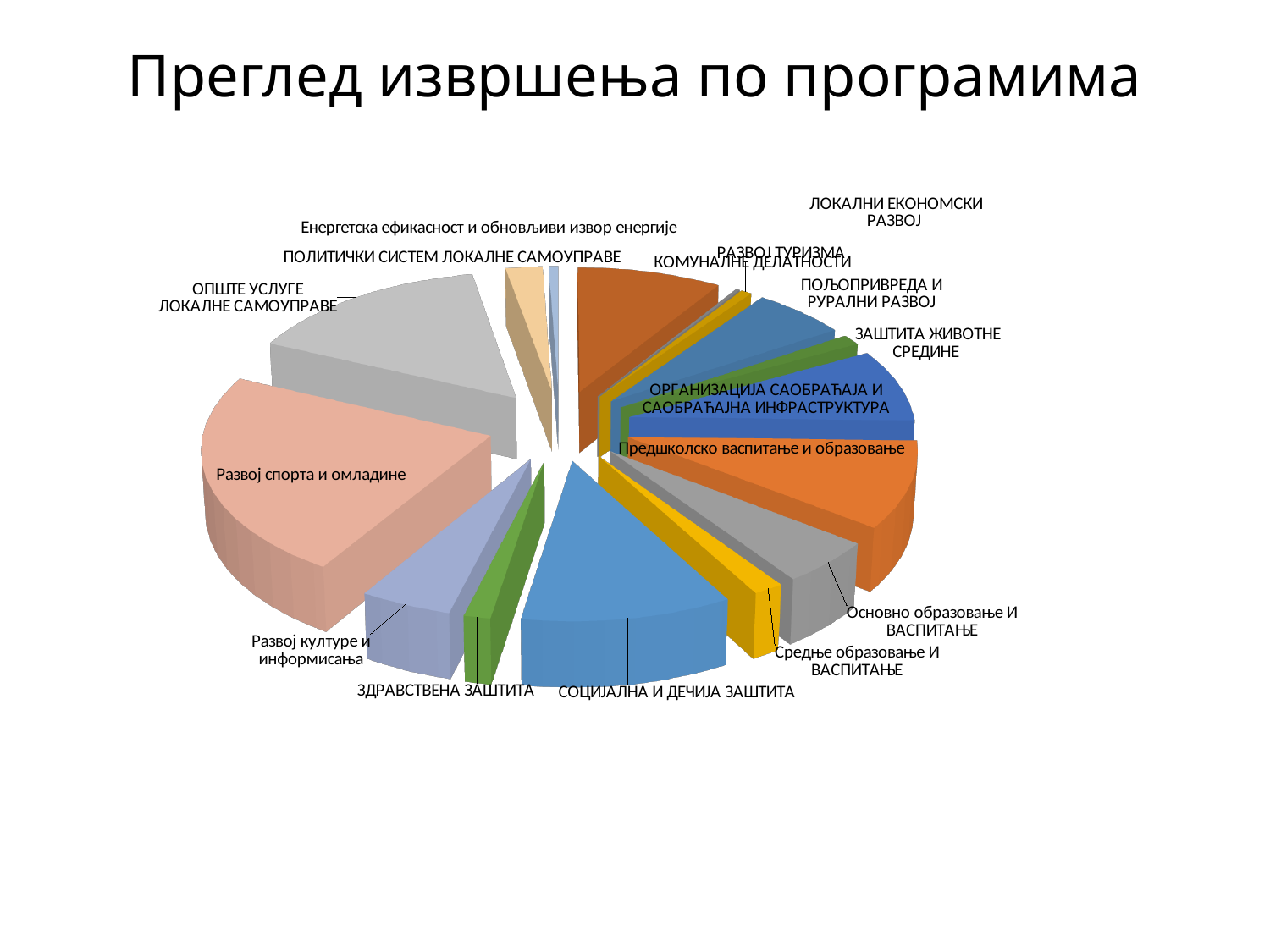
How many categories (slices) are labelled in the pie chart? 16 What kind of chart is shown on the slide? pie chart What is the title of the slide containing the chart? Преглед извршења по програмима Which slice is larger: Развој културе и информисања or Енергетска ефикасност и обновљиви извор енергије? Развој културе и информисања Which slice is larger: Развој спорта и омладине or ЗДРАВСТВЕНА ЗАШТИТА? Развој спорта и омладине Which slice is larger: Предшколско васпитање и образовање or ЗАШТИТА ЖИВОТНЕ СРЕДИНЕ? Предшколско васпитање и образовање Which category has the largest slice in the pie chart? Развој спорта и омладине Does the pie chart display numeric data labels on its slices? No